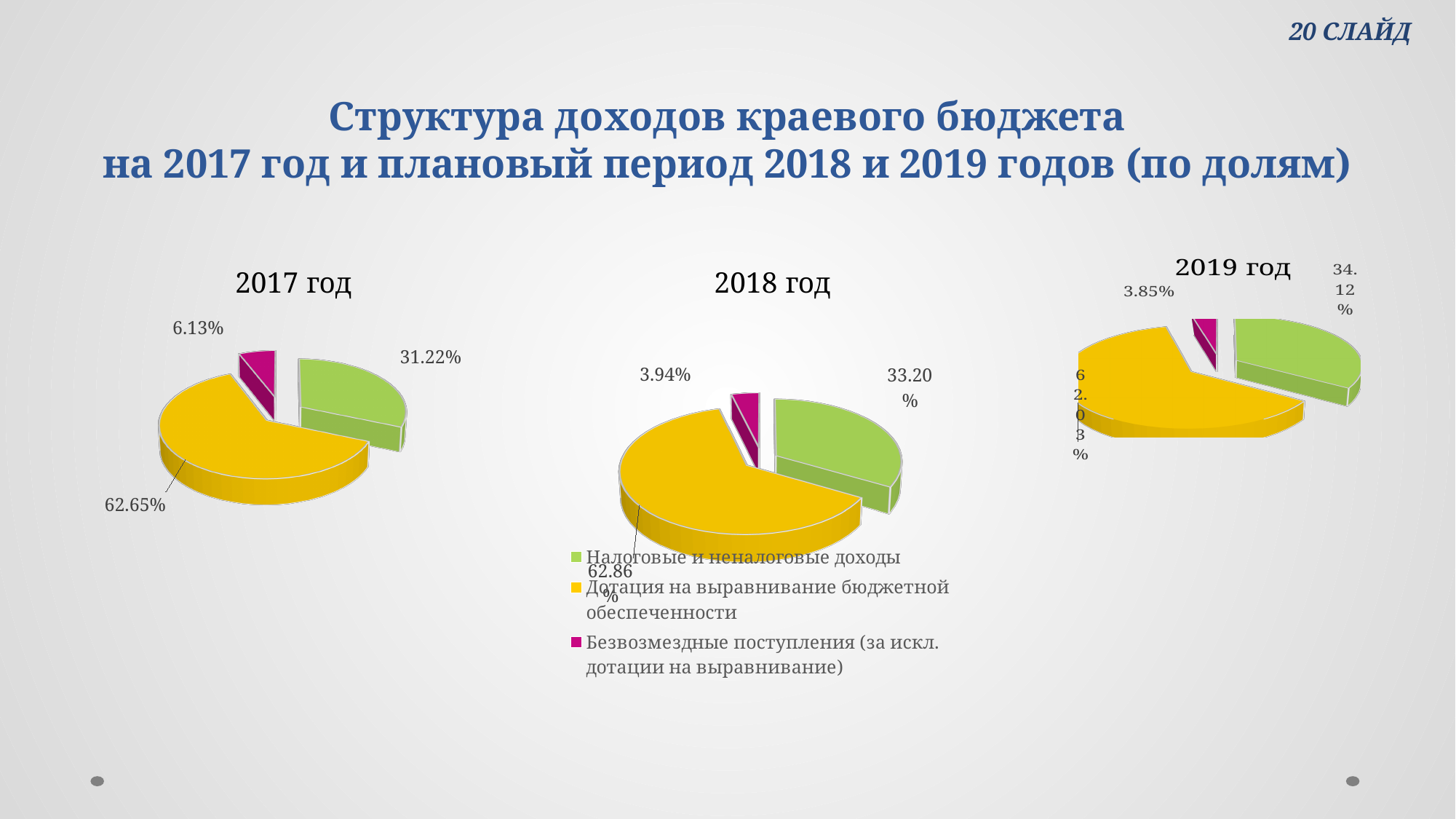
In the 2017 год pie chart, what share is shown for Безвозмездные поступления (за искл. дотации на выравнивание) (magenta slice)? 6.13% In the 2019 год pie chart, what share is shown for Налоговые и неналоговые доходы? 34.12% In the 2018 год pie chart, what share is shown for Налоговые и неналоговые доходы? 33.20% In the 2017 год pie chart, what is the difference between the shares of Дотация на выравнивание бюджетной обеспеченности and Налоговые и неналоговые доходы? 31.43% In the 2019 год pie chart, what share is shown for Безвозмездные поступления (за искл. дотации на выравнивание)? 3.85% How many series does the legend list for the pie charts? 3 In the 2017 год pie chart, what share is shown for Дотация на выравнивание бюджетной обеспеченности (yellow slice)? 62.65% In the 2017 год pie chart, what share is shown for Налоговые и неналоговые доходы (green slice)? 31.22% In the 2017 год pie chart, which category has the smallest share? Безвозмездные поступления (за искл. дотации на выравнивание) What kind of chart is used for 2017 год, 2018 год and 2019 год? Pie chart In the 2018 год pie chart, which category has the largest share? Дотация на выравнивание бюджетной обеспеченности In the 2018 год pie chart, what share is shown for Безвозмездные поступления (за искл. дотации на выравнивание)? 3.94%